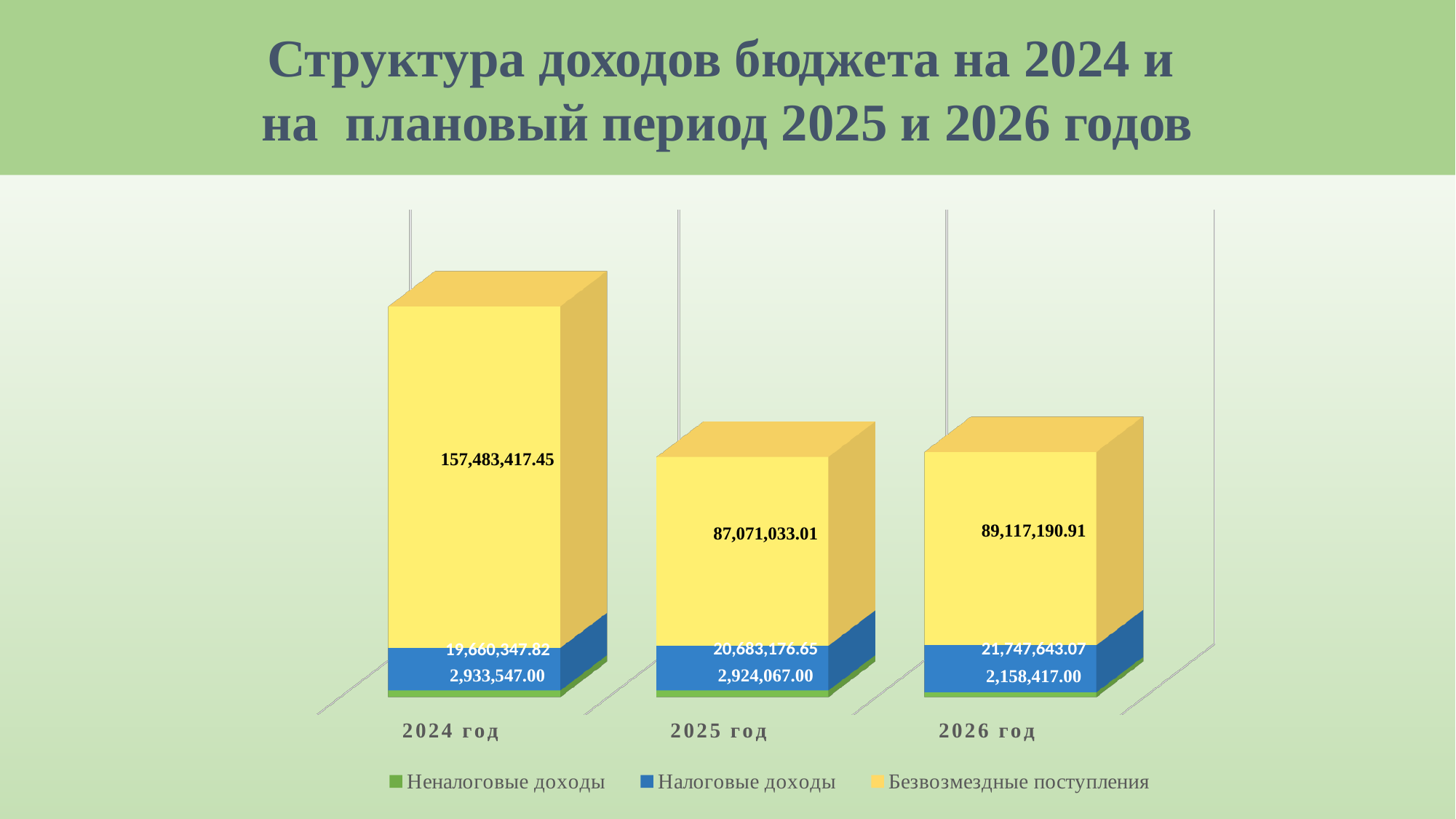
What is the value of Неналоговые доходы for 2026 год? 2,158,417.00 What type of chart is shown on the slide? Stacked bar chart What is the value of Налоговые доходы for 2025 год? 20,683,176.65 How many categories (years) are shown on the x axis? 3 What is the value of Безвозмездные поступления for 2024 год? 157,483,417.45 How many series does the legend list? 3 In which year is Неналоговые доходы the lowest? 2026 год What is the total of the stacked bar for 2025 год? 110,678,276.66 Which colour represents Налоговые доходы in the legend? Blue Which is larger: Налоговые доходы in 2024 год or in 2026 год? 2026 год What is the difference between Безвозмездные поступления in 2026 год and in 2025 год? 2,046,157.90 In which year is Безвозмездные поступления the highest? 2024 год